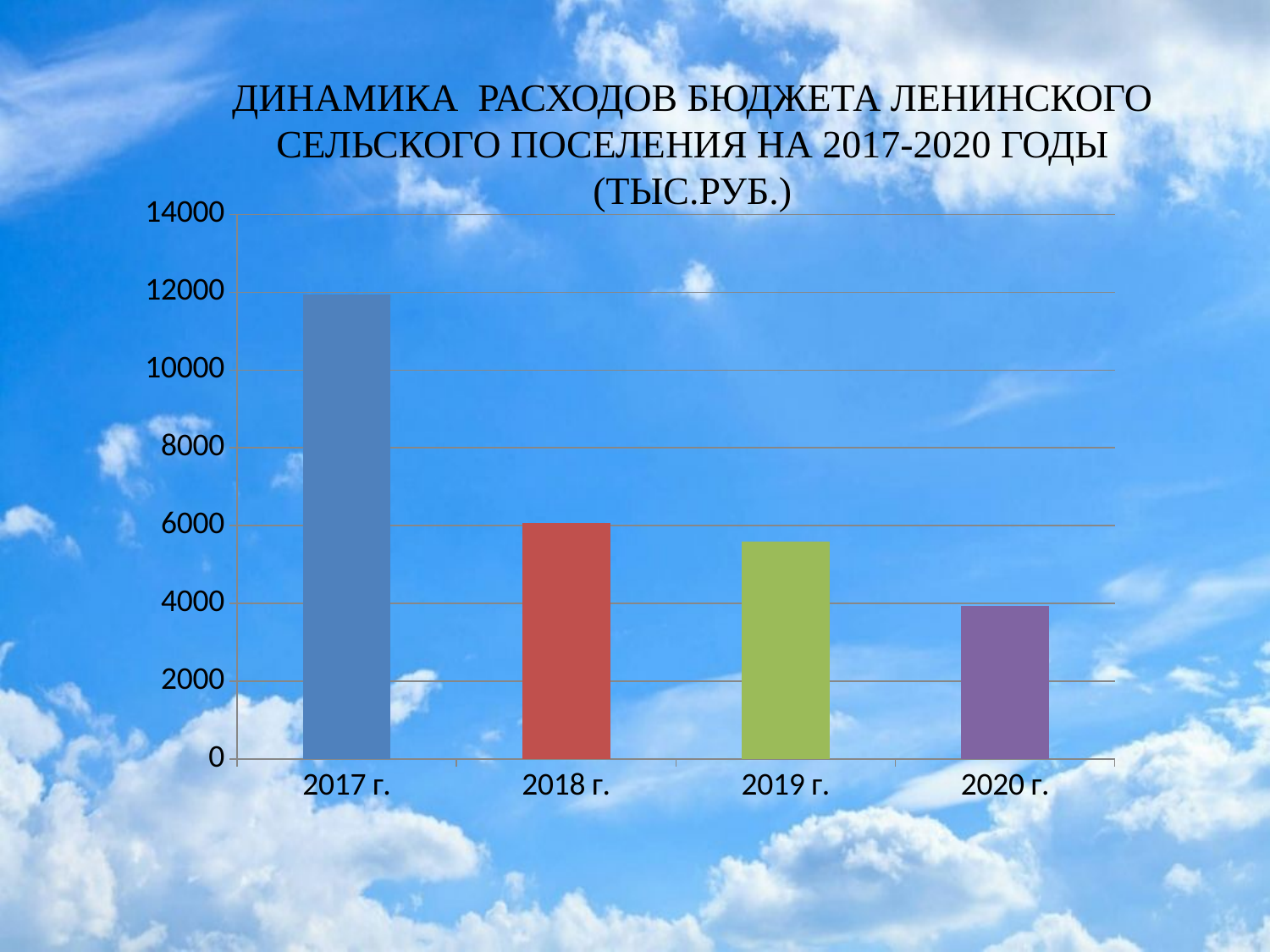
Which year has the lowest budget expenditure on the chart? 2020 г. How many years (categories) are plotted on the chart? 4 Is the value for 2017 г. greater or less than 10000? greater Which year has the highest budget expenditure on the chart? 2017 г. What kind of chart is shown on the slide? bar chart Is the value for 2018 г. greater or less than 8000? less In what units are the values on the chart expressed, according to the title? тыс.руб. Is the value for 2019 г. greater or less than 6000? less Which is larger, the value for 2018 г. or the value for 2019 г.? 2018 г. Do the values rise or fall from 2017 г. to 2020 г.? fall